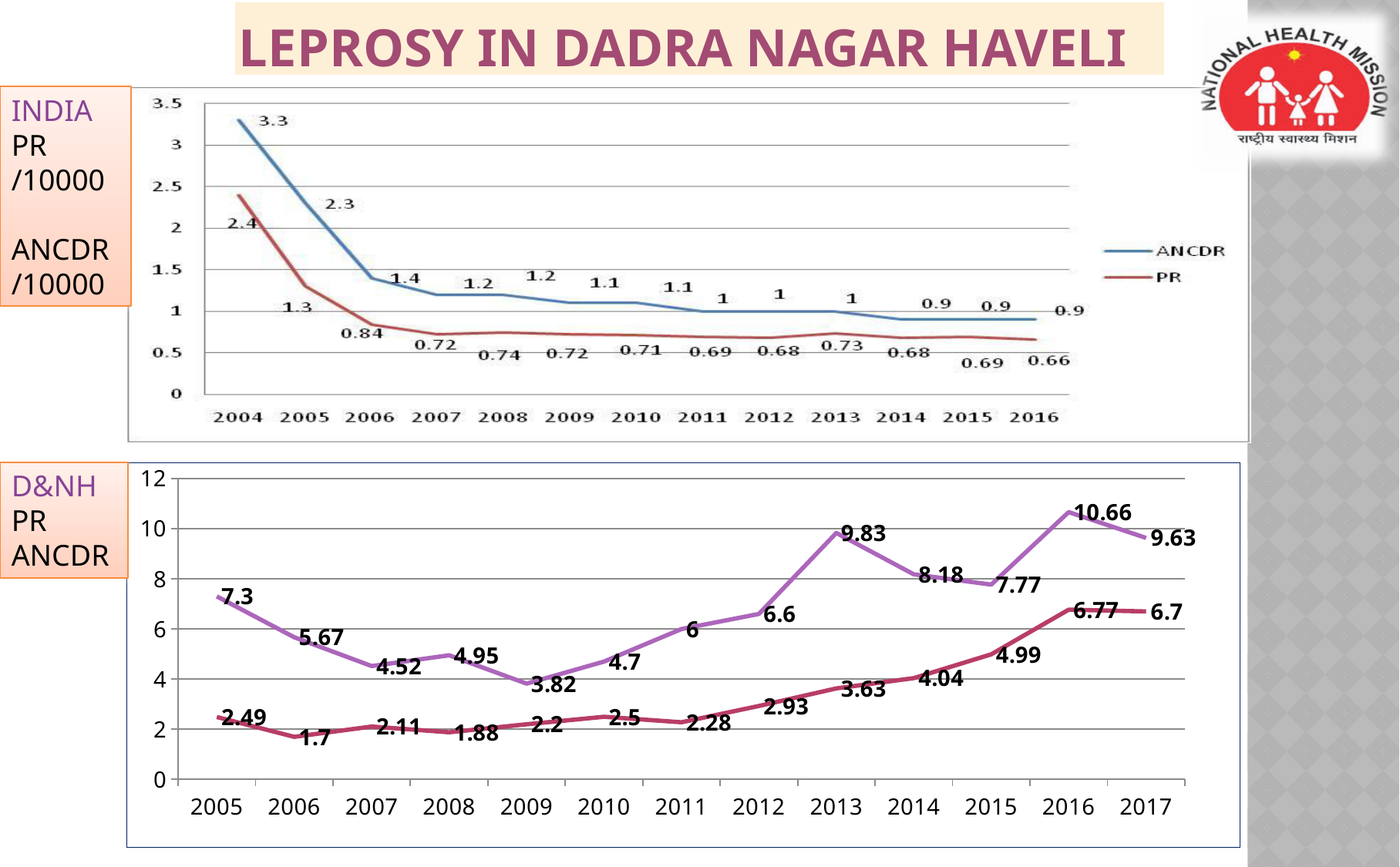
In the top (INDIA) chart, what is the ANCDR value for 2004? 3.3 In the bottom (D&NH) chart, what is the value of the purple line in 2016? 10.66 In the bottom (D&NH) chart, in which year does the purple line reach its highest value? 2016 In the top (INDIA) chart, which year has the lowest PR value? 2016 In the bottom (D&NH) chart, how many years are shown on the x axis? 13 In the top (INDIA) chart, what is the PR value for 2016? 0.66 In the top (INDIA) chart, what is the difference between the ANCDR and PR values in 2004? 0.9 In the top (INDIA) chart, how many series does the legend list? 2 In the top (INDIA) chart, does the ANCDR line rise or fall from 2004 to 2016? fall In the bottom (D&NH) chart, in which year does the purple line reach its lowest value? 2009 In the bottom (D&NH) chart, what is the value of the red line in 2006? 1.7 What type of chart is the bottom (D&NH) chart? line chart